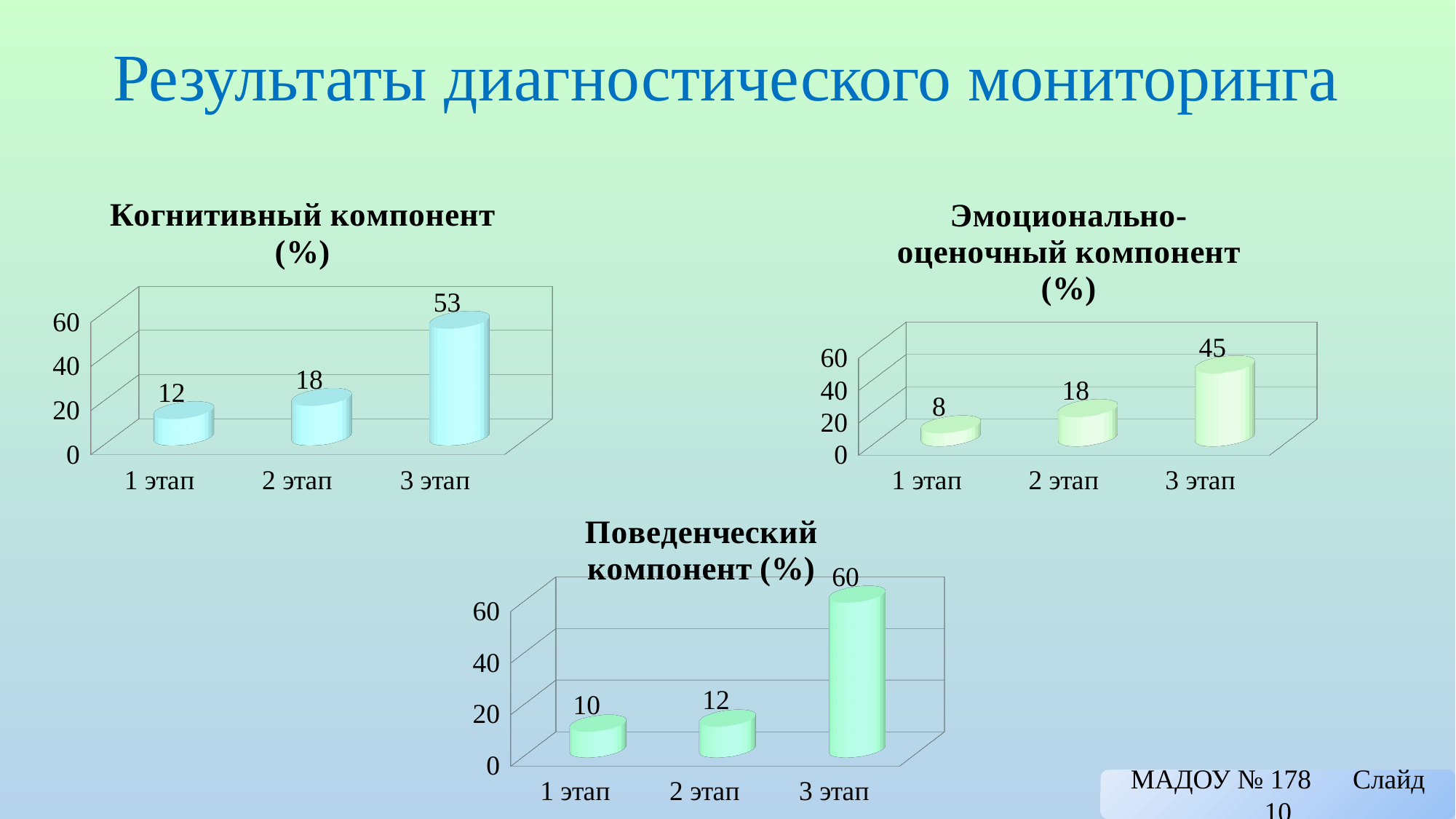
In the 'Когнитивный компонент (%)' chart, do the values rise or fall from 1 этап to 3 этап? rise In the 'Когнитивный компонент (%)' chart, what is the value for 3 этап? 53 What kind of chart is the 'Поведенческий компонент (%)' chart? bar chart Which is larger: the value for 3 этап in the 'Когнитивный компонент (%)' chart or the value for 3 этап in the 'Эмоционально-оценочный компонент (%)' chart? Когнитивный компонент (%) In the 'Поведенческий компонент (%)' chart, what is the value for 2 этап? 12 In the 'Когнитивный компонент (%)' chart, what is the difference between the values for 3 этап and 2 этап? 35 In the 'Эмоционально-оценочный компонент (%)' chart, what is the value for 1 этап? 8 In the 'Эмоционально-оценочный компонент (%)' chart, what is the difference between the values for 3 этап and 1 этап? 37 In the 'Поведенческий компонент (%)' chart, is the value for 3 этап greater or less than 40? greater In the 'Поведенческий компонент (%)' chart, which stage has the highest value? 3 этап In the 'Когнитивный компонент (%)' chart, which stage has the lowest value? 1 этап How many categories are shown in the 'Эмоционально-оценочный компонент (%)' chart? 3